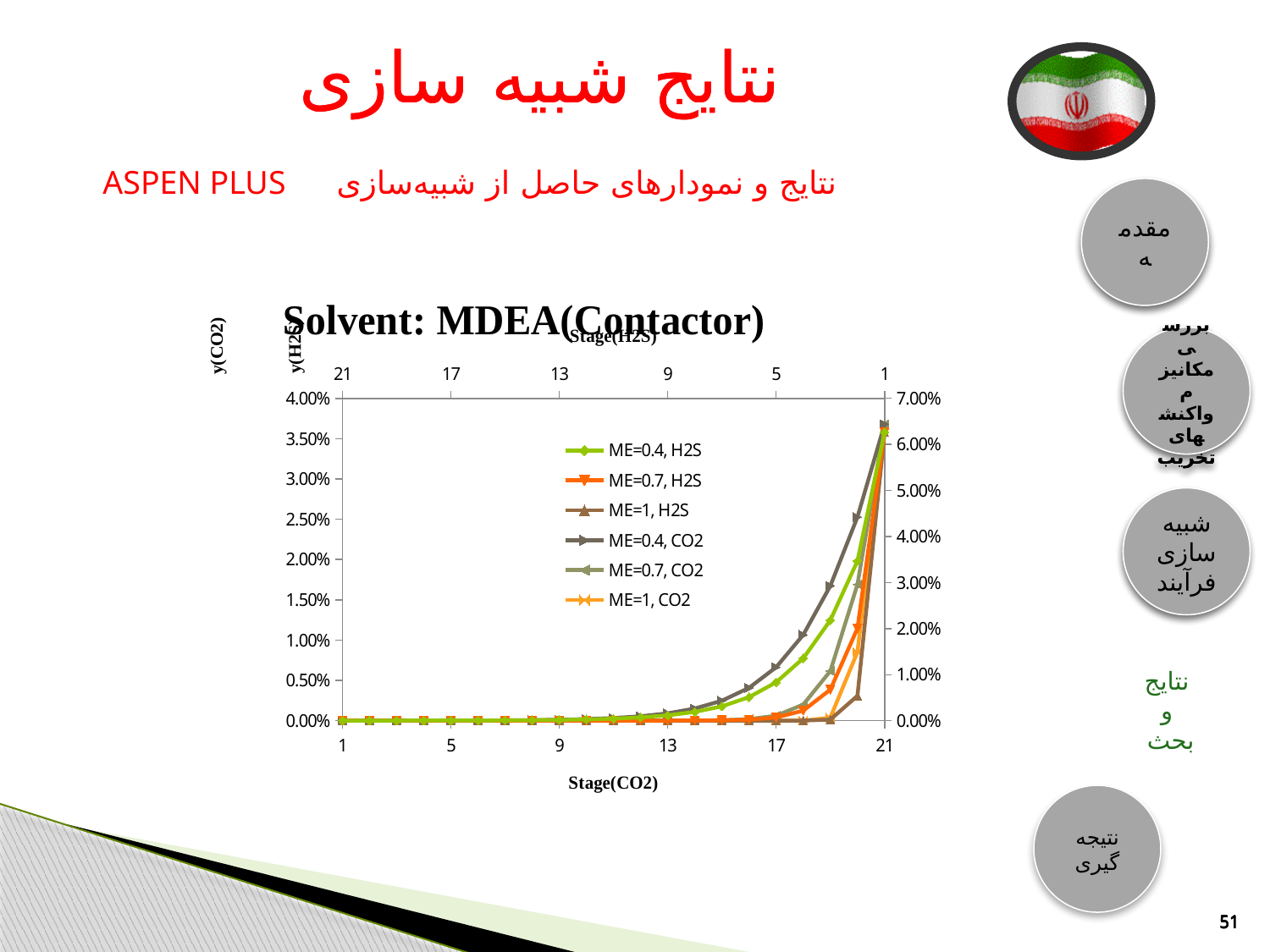
What is the title of the chart? Solvent: MDEA(Contactor) At stage 18 on the bottom axis, which series has the larger value: ME=0.4, CO2 or ME=0.7, CO2? ME=0.4, CO2 At stage 17 on the bottom axis, which series has the larger value: ME=0.4, CO2 or ME=1, CO2? ME=0.4, CO2 Is the value for ME=0.4, CO2 at stage 9 greater or less than 0.50% on the left axis? less Is the value for ME=0.4, CO2 at stage 5 greater or less than 1.00% on the left axis? less Along the bottom x axis (Stage(CO2)) from stage 1 to stage 21, do the values of the ME=0.4, CO2 series rise or fall? rise What kind of chart is shown on the slide? line chart How many series does the legend of the chart list? 6 What is the label of the bottom x axis of the chart? Stage(CO2)